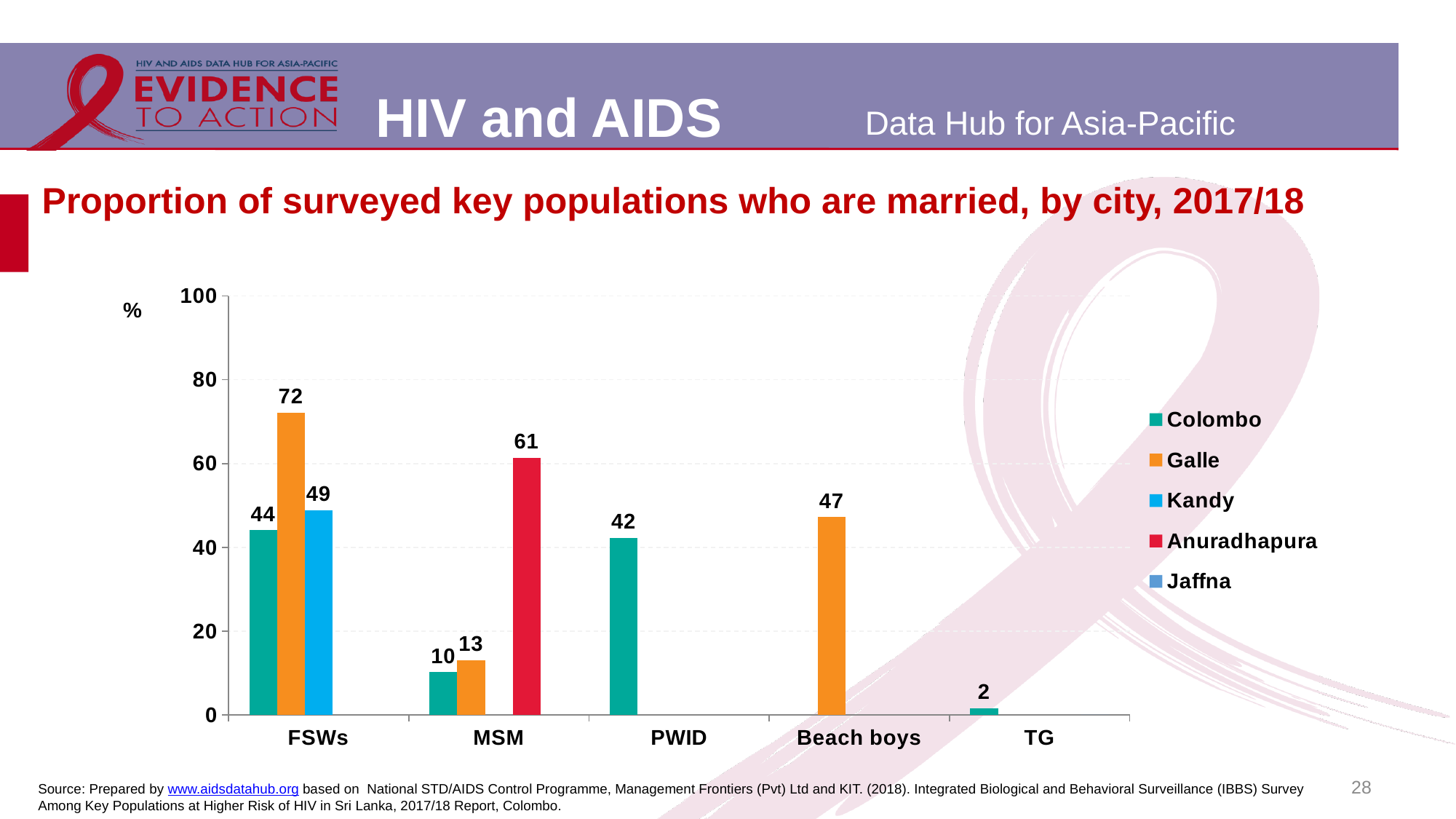
What is the value for Anuradhapura among MSM? 61 Which city has the highest value among FSWs? Galle How many key population categories are shown on the x axis? 5 How many cities does the legend list? 5 Which city has the lowest value among MSM? Colombo Is the value for Galle among Beach boys greater or less than 40? greater What is the value for Colombo among TG? 2 What is the difference between the Galle and Colombo values for FSWs? 28 What kind of chart is shown on the slide? bar chart Among FSWs, which is larger: the value for Kandy or the value for Colombo? Kandy What is the value for Galle among FSWs? 72 What is the value for Colombo among PWID? 42